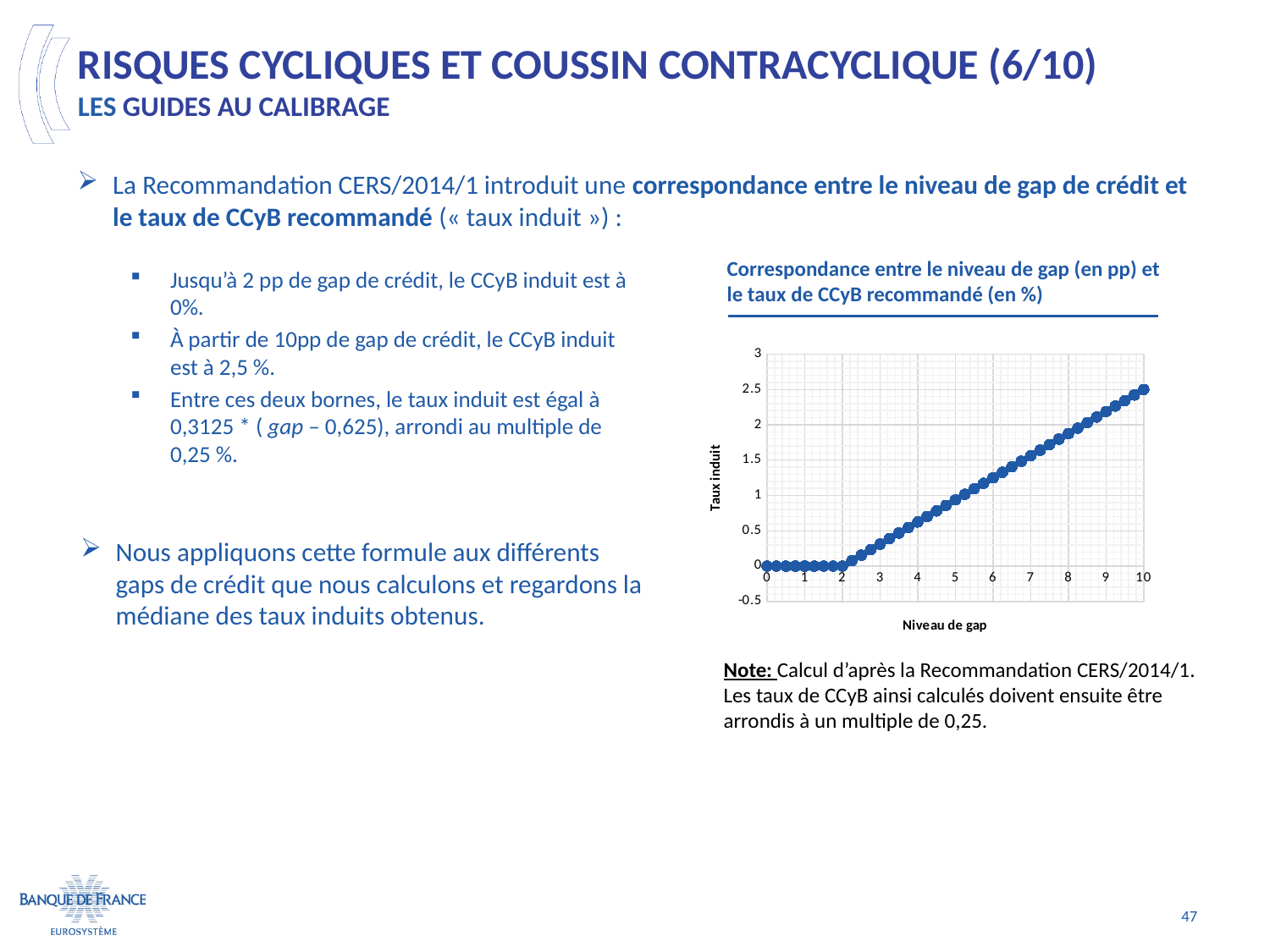
Is the Taux induit at a Niveau de gap of 3 greater or less than 0.5? less What is the Taux induit value when the Niveau de gap is 2? 0 What is the Taux induit value when the Niveau de gap is 10? 2.5 What is the title of the chart? Correspondance entre le niveau de gap (en pp) et le taux de CCyB recommandé (en %) Which is larger, the Taux induit at a Niveau de gap of 4 or at a Niveau de gap of 8? 8 What is the Taux induit value when the Niveau de gap is 0? 0 At which Niveau de gap does the Taux induit reach its highest value? 10 What is the label of the x axis of the chart? Niveau de gap Is the Taux induit at a Niveau de gap of 6 greater or less than 1.5? less Is the Taux induit at a Niveau de gap of 8 greater or less than 2? less What type of chart is shown on the slide? line chart Does the Taux induit rise or fall as the Niveau de gap increases from 2 to 10? rise